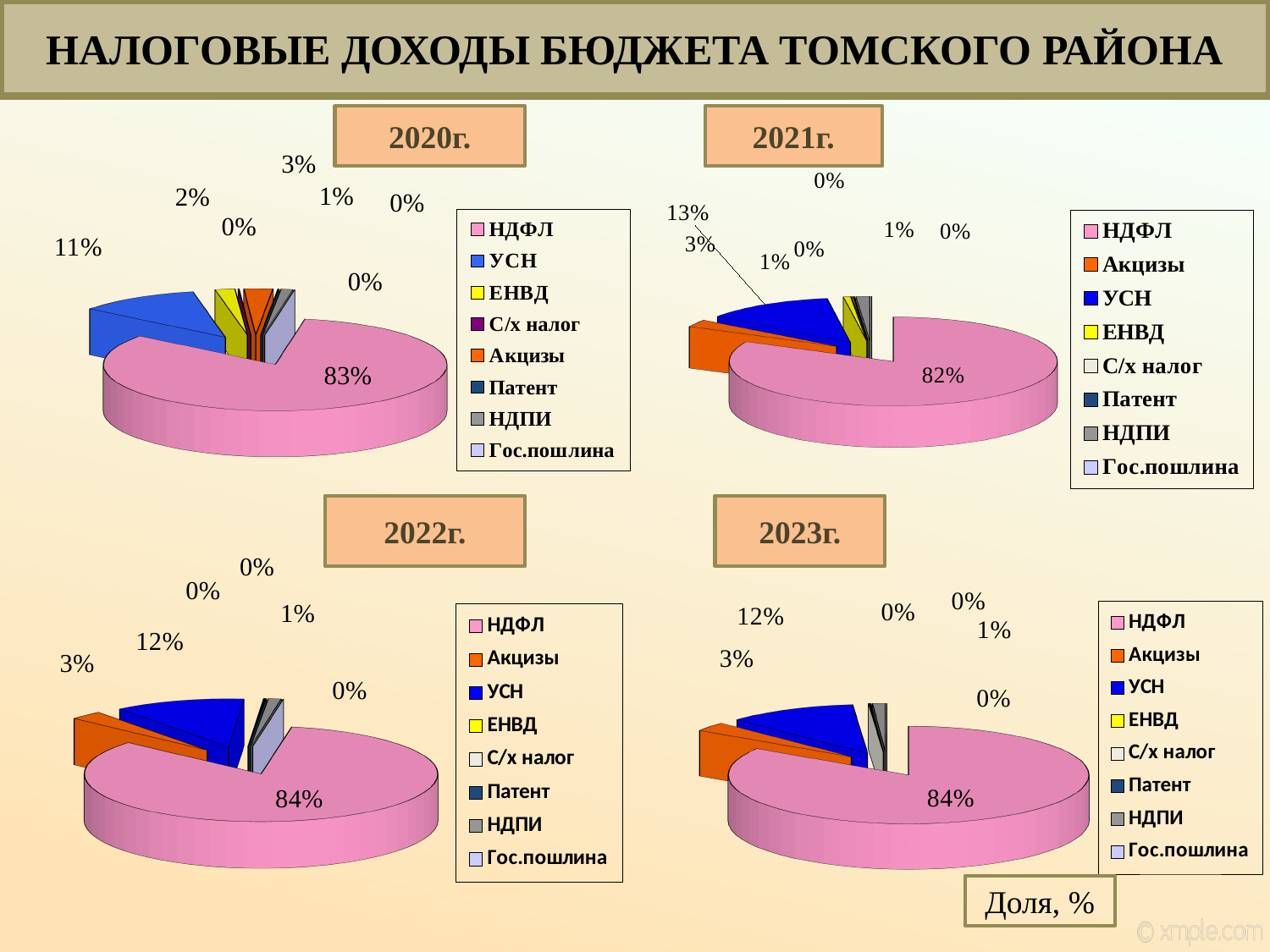
Is the НДФЛ share larger in the 2020г. chart or in the 2021г. chart? 2020г. In the 2020г. pie chart, by how many percentage points does the НДФЛ share exceed the УСН share? 72 In the 2020г. pie chart, what share does УСН have? 11% In the 2023г. pie chart, what share does НДФЛ have? 84% In the 2021г. pie chart, what share does НДФЛ have? 82% What kind of chart is used for the 2023г. data? Pie chart In the 2022г. pie chart, what share does НДФЛ have? 84% How many entries does the legend of the 2020г. chart list? 8 In the 2021г. pie chart, what share does УСН have? 13% In the 2022г. pie chart, which category has the largest slice? НДФЛ How many pie charts are shown on the slide? 4 In the 2020г. pie chart, what share does НДФЛ have? 83%